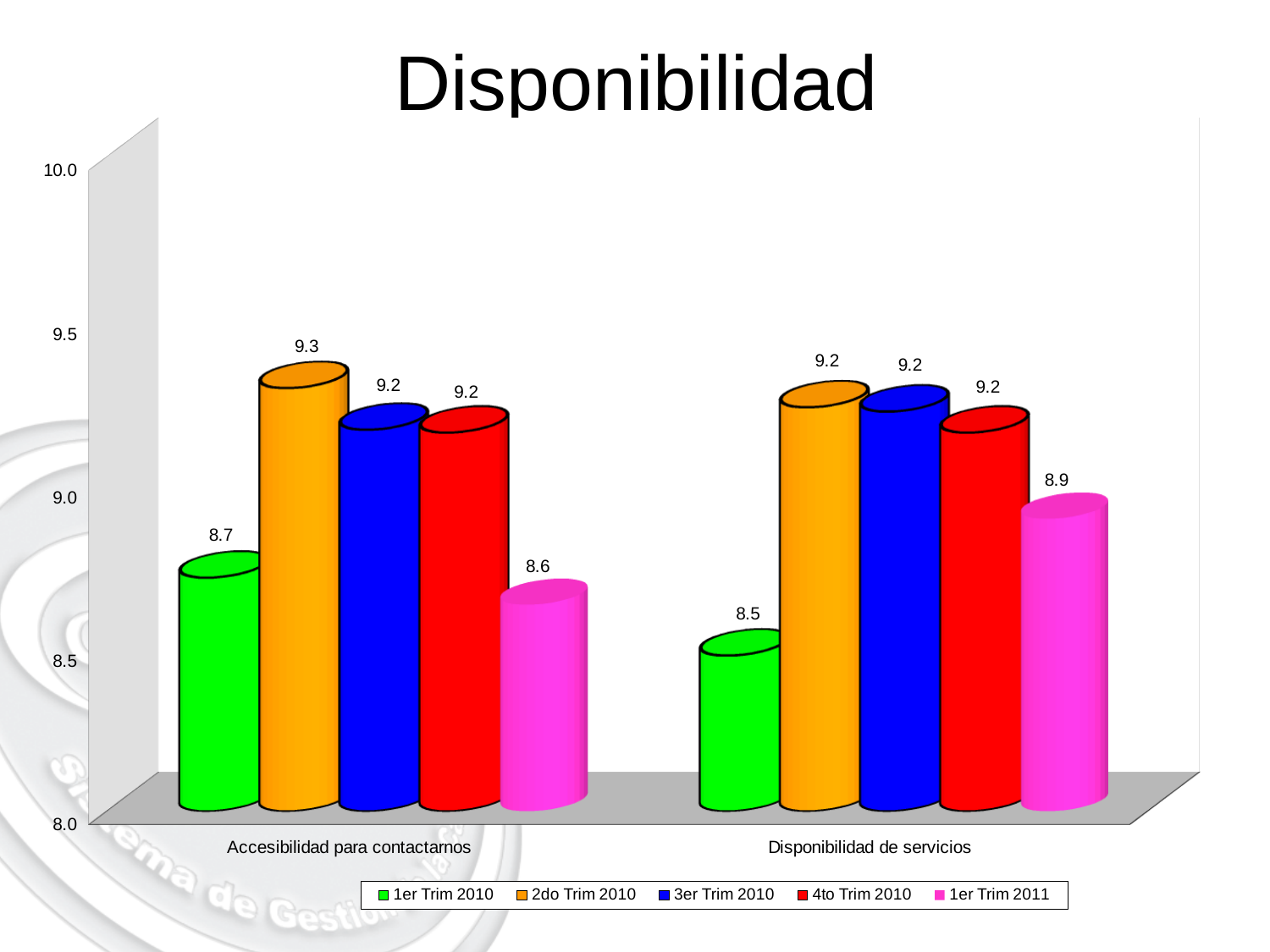
What is the difference between the 2do Trim 2010 value and the 1er Trim 2011 value in the Accesibilidad para contactarnos category? 0.7 How many series does the legend list? 5 Which is larger: the 1er Trim 2011 value for Accesibilidad para contactarnos or for Disponibilidad de servicios? Disponibilidad de servicios Is the value for 1er Trim 2010 in Accesibilidad para contactarnos greater or less than 9.0? less What is the title of the chart? Disponibilidad Which series has the lowest value in the Disponibilidad de servicios category? 1er Trim 2010 What is the value for 1er Trim 2010 in the Disponibilidad de servicios category? 8.5 How many categories are shown on the x axis? 2 What is the value for 1er Trim 2011 in the Disponibilidad de servicios category? 8.9 What is the value for 2do Trim 2010 in the Accesibilidad para contactarnos category? 9.3 What kind of chart is shown on the slide? bar chart Which series has the highest value in the Accesibilidad para contactarnos category? 2do Trim 2010